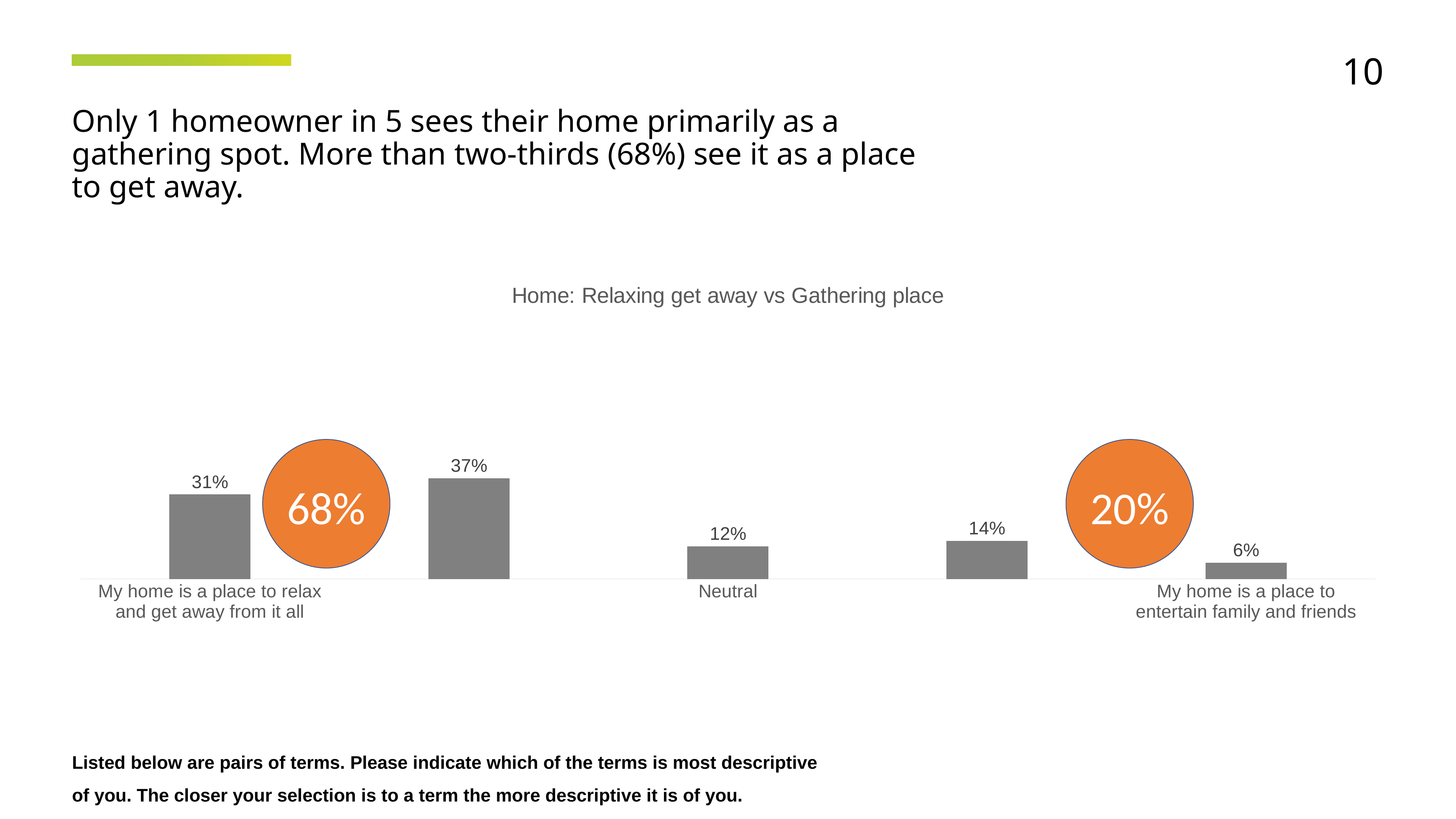
What is the title of the chart? Home: Relaxing get away vs Gathering place What is the value of the bar labelled "Neutral"? 12% What is the combined value of the two bars to the left of "Neutral" (31% and 37%)? 68% What is the value of the bar labelled "My home is a place to entertain family and friends"? 6% What kind of chart is shown on the slide? bar chart What is the highest value shown on any bar in the chart? 37% What value is shown in the orange circle on the left side of the chart? 68% Which is larger: the bar for "My home is a place to relax and get away from it all" or the bar for "Neutral"? My home is a place to relax and get away from it all What is the difference between the "Neutral" bar and the "My home is a place to entertain family and friends" bar? 6 percentage points Which labelled category has the lowest bar? My home is a place to entertain family and friends How many bars are plotted in the chart? 5 What is the value of the bar labelled "My home is a place to relax and get away from it all"? 31%